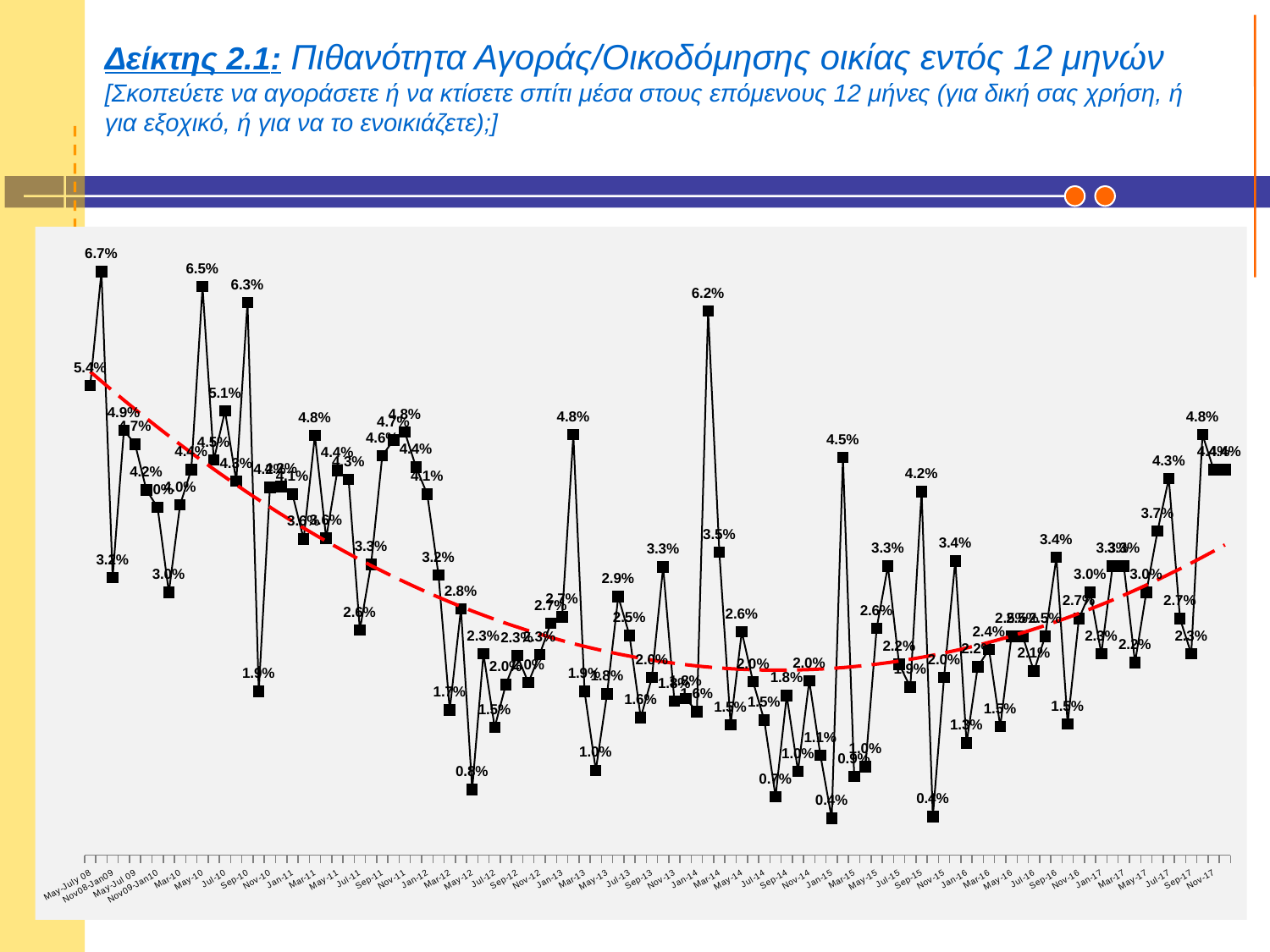
What is the highest value labeled on the chart? 6.7% What is the value of the last data point (Nov-17)? 4.4% What is the lowest value labeled on the chart? 0.4% Which is larger, the peak at the start of the series (6.7%) or the spike at Mar-14 (6.2%)? 6.7% What is the index number given in the chart title? Δείκτης 2.1 What is the difference between the highest labeled value (6.7%) and the lowest labeled value (0.4%)? 6.3 percentage points What is the difference between the 6.7% peak and the 6.2% spike at Mar-14? 0.5 percentage points What colour and style is the trend line drawn on the chart? Red dashed Does the red dashed trend line fall or rise from the start of the series to around 2014? Fall What kind of chart is shown on the slide? Line chart Does the red dashed trend line rise or fall from 2015 to the end of the series? Rise